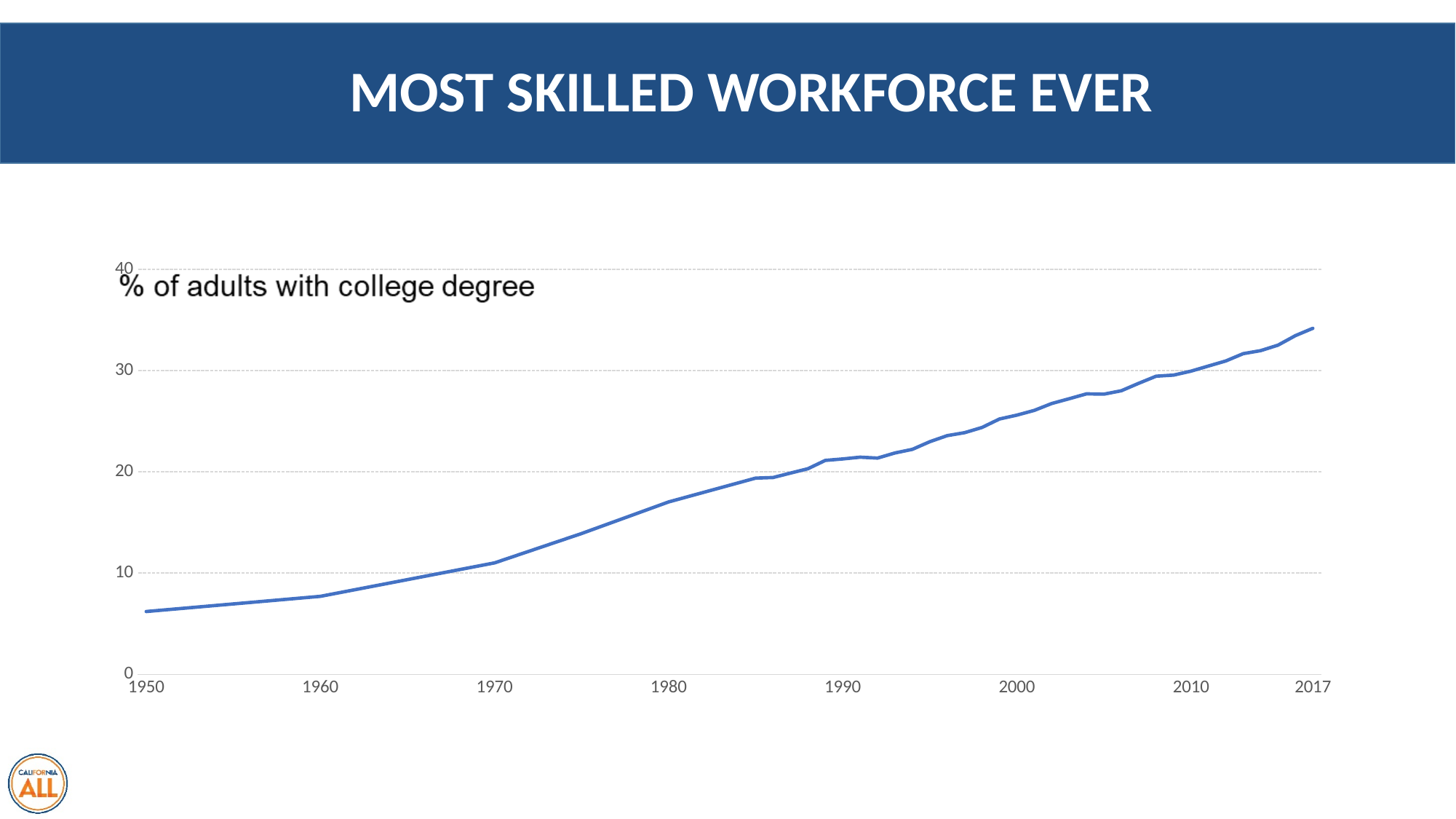
How many year labels are shown on the x axis? 8 Is the value for 1950 greater or less than 10? less Is the value for 2000 greater or less than 30? less Does the percentage of adults with a college degree rise or fall from 1950 to 2017? rise Is the value for 2017 greater or less than 30? greater What kind of chart is shown on the slide? line chart Which year has a higher percentage of adults with a college degree, 1960 or 1990? 1990 Which year on the x axis has the lowest percentage of adults with a college degree? 1950 What does the chart's label say the line measures? % of adults with college degree What is the title of the slide containing the chart? MOST SKILLED WORKFORCE EVER Which year on the x axis has the highest percentage of adults with a college degree? 2017